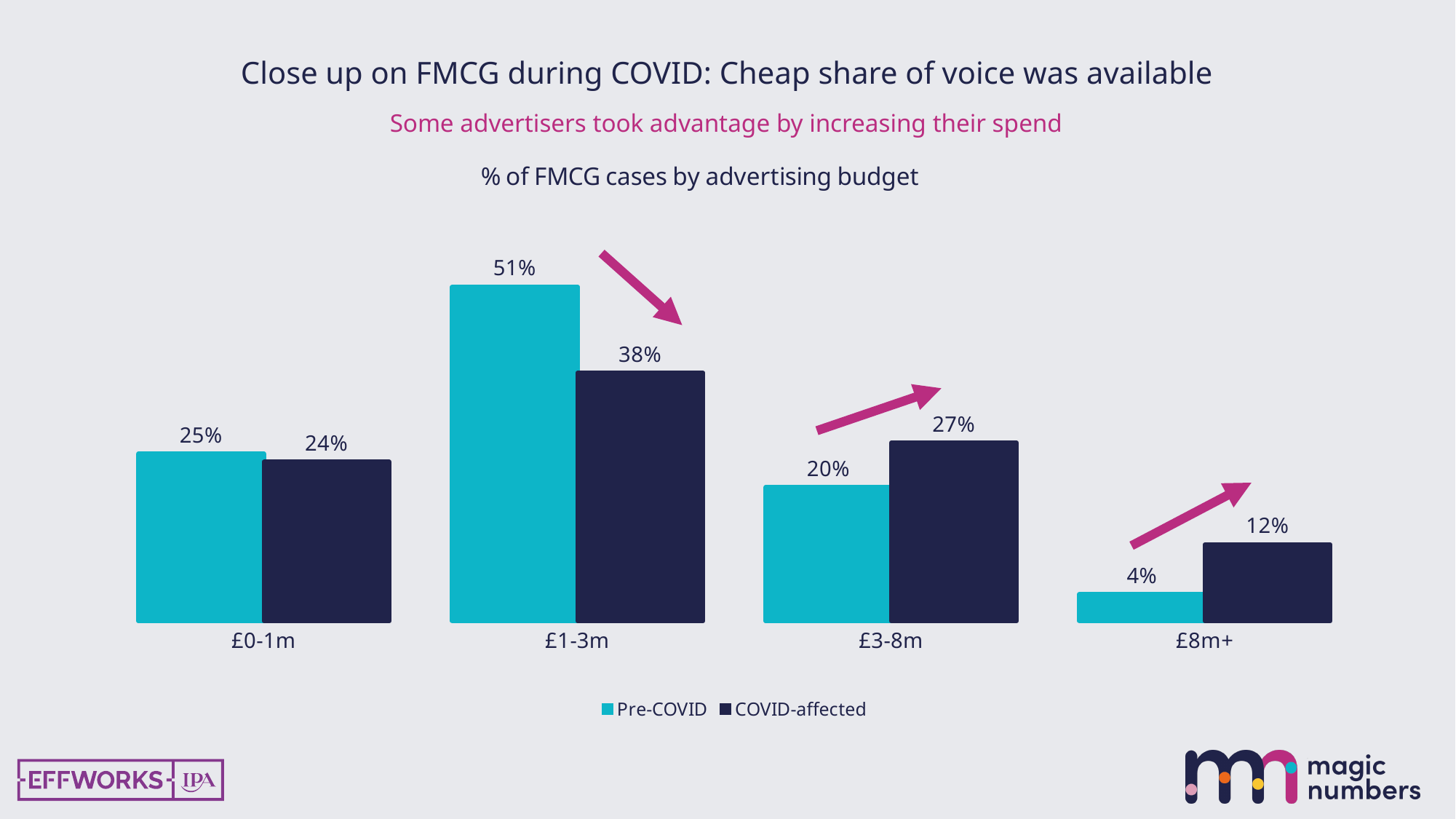
How many budget bands are shown on the x axis? 4 What is the difference between the Pre-COVID and COVID-affected values for the £1-3m budget band? 13% What is the COVID-affected value for the £8m+ budget band? 12% What is the difference between the COVID-affected and Pre-COVID values for the £8m+ budget band? 8% Which budget band has the lowest Pre-COVID value? £8m+ What is the title of the chart? % of FMCG cases by advertising budget What is the Pre-COVID value for the £1-3m budget band? 51% For the £3-8m budget band, which is larger: the Pre-COVID value or the COVID-affected value? COVID-affected Which budget band has the highest COVID-affected value? £1-3m How many series does the legend list? 2 What is the Pre-COVID value for the £3-8m budget band? 20% What kind of chart is shown on the slide? Bar chart